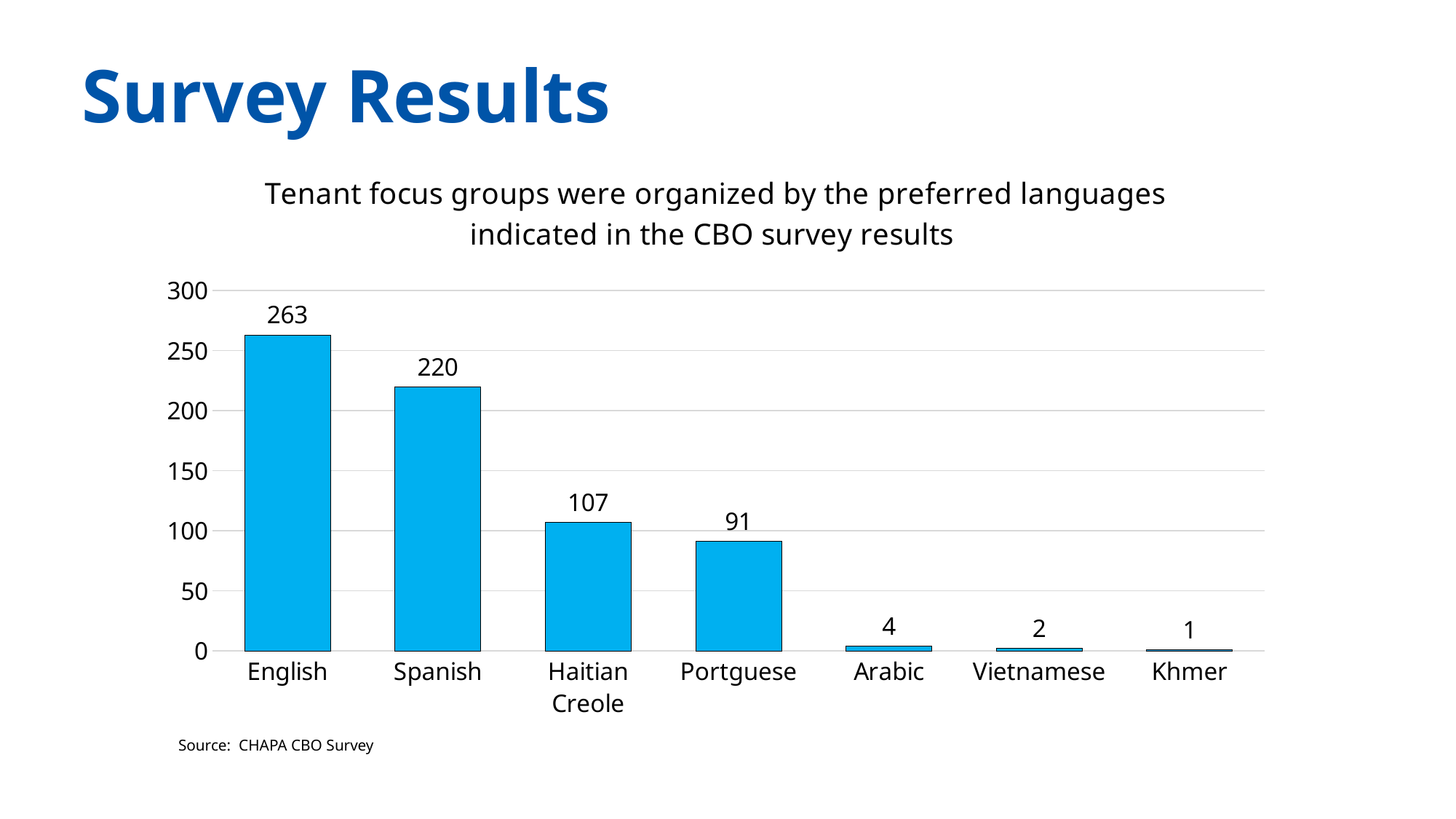
Is the value for Spanish greater or less than 200? greater What is the difference between the values for Haitian Creole and Portguese? 16 Which language has the highest value? English Which is larger, the value for Portguese or the value for Arabic? Portguese What is the difference between the values for English and Spanish? 43 What is the value for Vietnamese? 2 What kind of chart is shown on the slide? bar chart What is the value for Haitian Creole? 107 What source is cited below the chart? CHAPA CBO Survey What is the value for English? 263 Which language has the lowest value? Khmer How many languages are shown on the x axis? 7